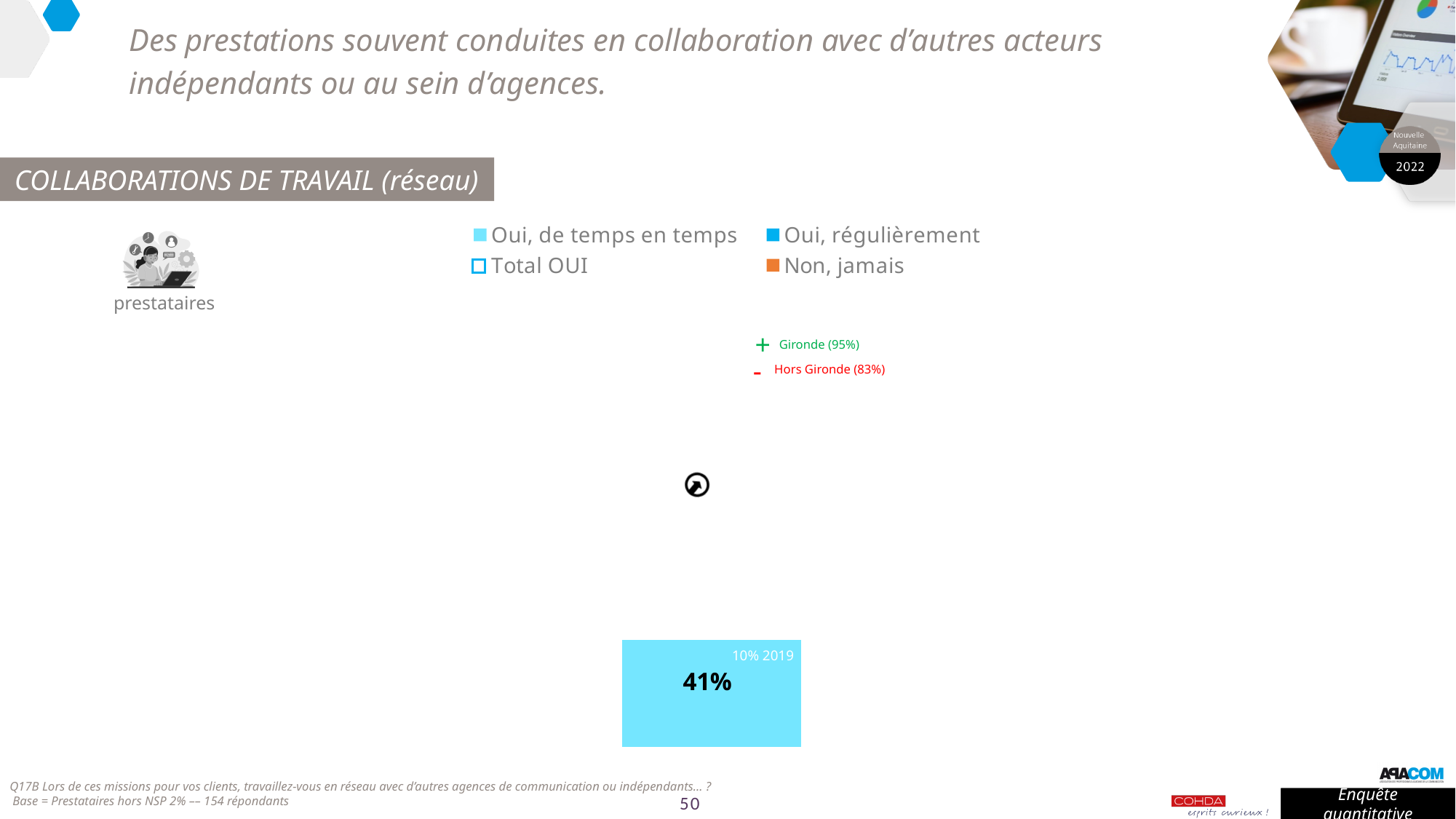
Is the value for 'Oui, de temps en temps' greater or less than 50%? less What value is printed on the light blue bar segment for 'Oui, de temps en temps'? 41% How many series does the chart legend list? 4 Which is larger, the percentage for Gironde or for Hors Gironde? Gironde Which legend entry is shown as a hollow blue square? Total OUI What percentage is shown for Hors Gironde in the annotation next to the chart? 83% What is the difference between the Gironde percentage and the Hors Gironde percentage? 12 points What percentage is shown for Gironde in the annotation next to the chart? 95% Which legend entry is shown in orange? Non, jamais What 2019 value is printed on the 'Oui, de temps en temps' segment? 10%